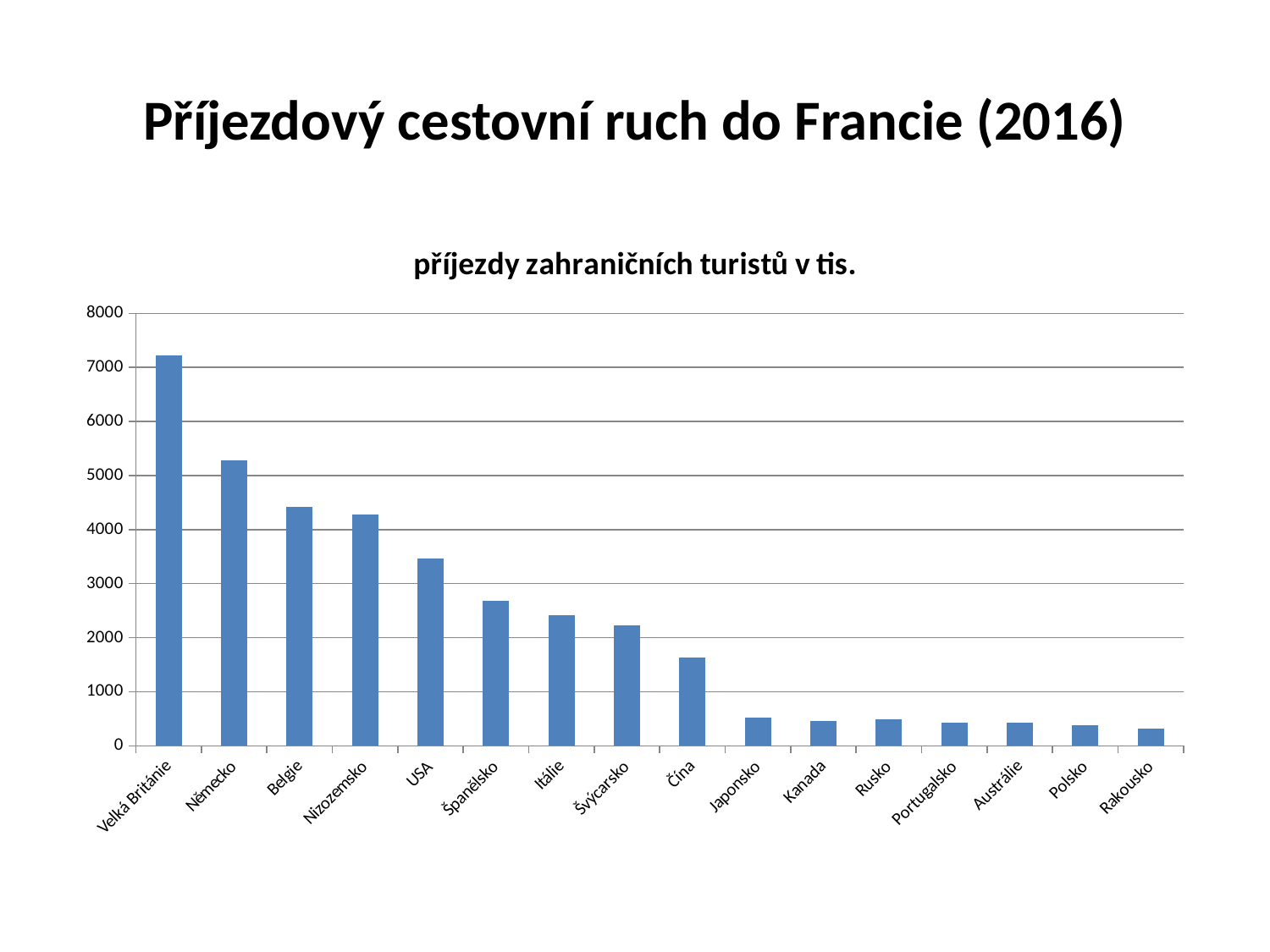
Is the value for Velká Británie greater or less than 7000? greater Which country has the lowest number of tourist arrivals in the chart? Rakousko Is the value for Japonsko greater or less than 1000? less How many countries are shown on the x axis of the chart? 16 Which has a higher value, Německo or Belgie? Německo Do the values rise or fall from left to right along the x axis? fall Is the value for Německo greater or less than 5000? greater Which country has the highest number of tourist arrivals in the chart? Velká Británie What kind of chart is shown on the slide? bar chart